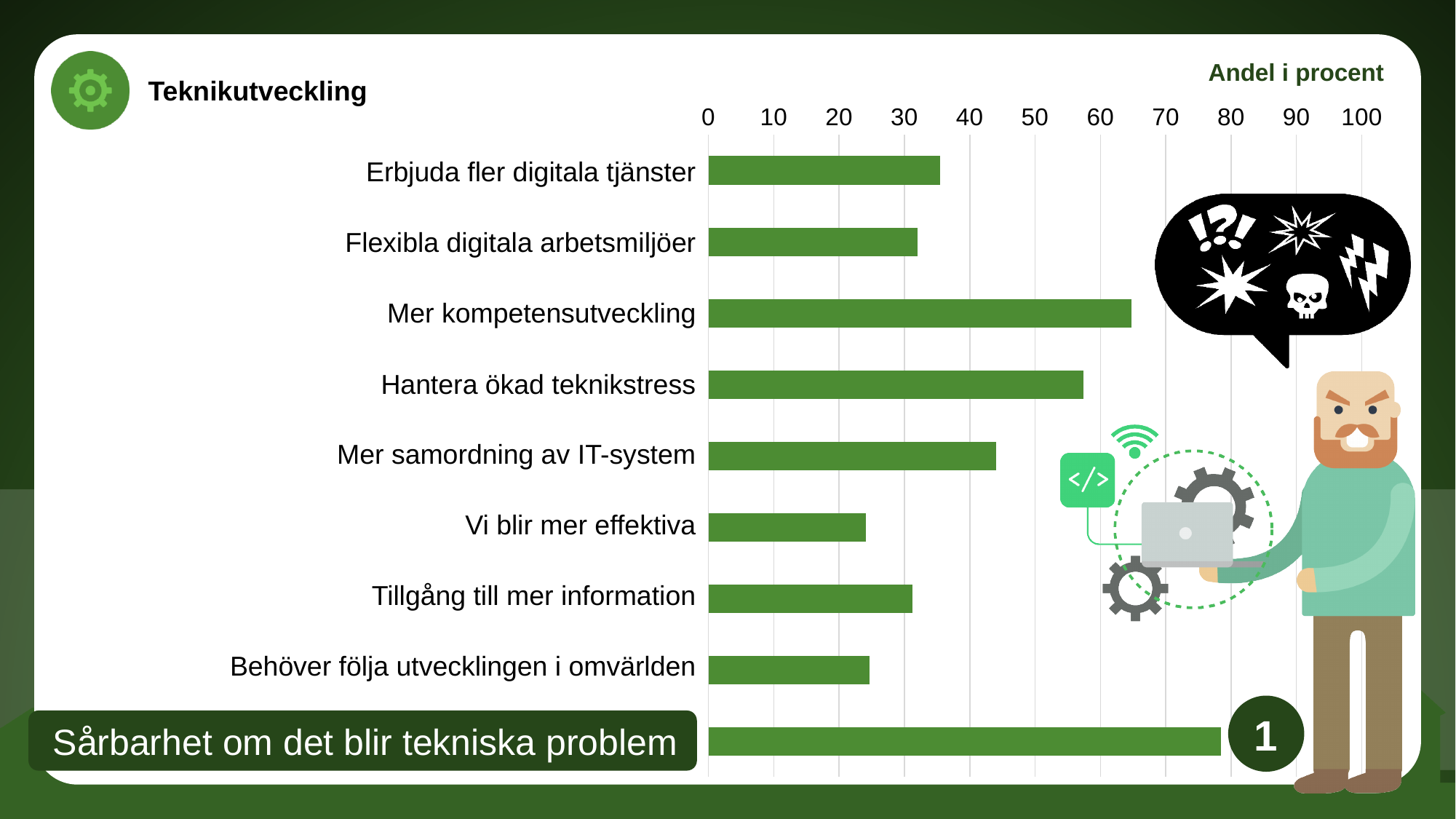
Is the value for Hantera ökad teknikstress greater or less than 50? greater What kind of chart is shown on the slide? bar chart Is the value for Vi blir mer effektiva greater or less than 30? less Which category has the highest value in the chart? Sårbarhet om det blir tekniska problem Is the value for Mer kompetensutveckling greater or less than 60? greater Which is larger, the value for Mer kompetensutveckling or the value for Hantera ökad teknikstress? Mer kompetensutveckling How many categories are plotted in the chart? 9 What unit label is shown above the chart's value axis? Andel i procent What is the title of the chart? Teknikutveckling Which is larger, the value for Erbjuda fler digitala tjänster or the value for Vi blir mer effektiva? Erbjuda fler digitala tjänster